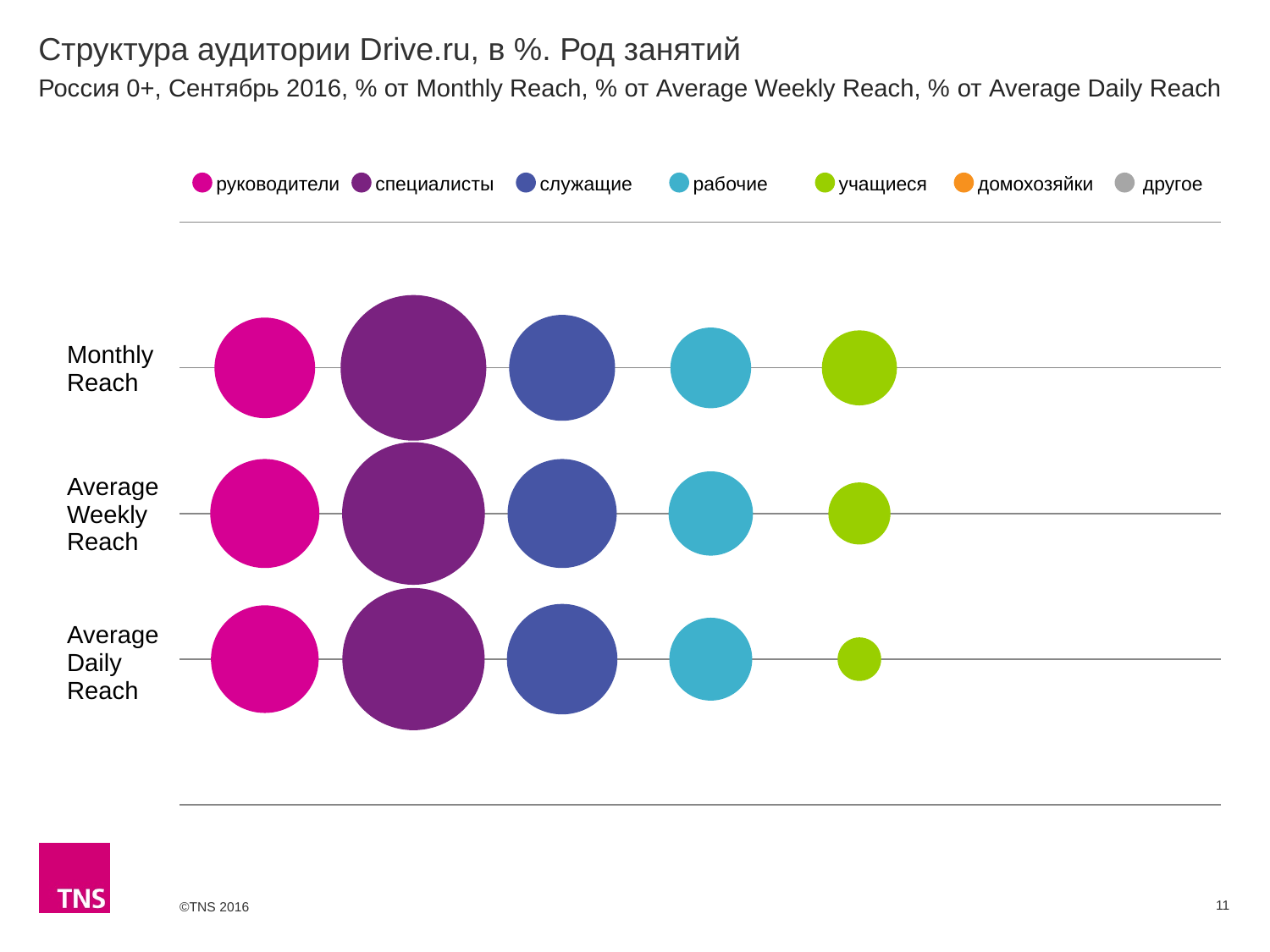
Which occupation group has the largest bubble in the Average Daily Reach row? специалисты In the Average Weekly Reach row, which bubble is larger: специалисты or руководители? специалисты Which occupation group has the largest bubble in the Monthly Reach row? специалисты How many reach categories (rows) are plotted on the chart? 3 How many series does the legend list? 7 Does the bubble for учащиеся get larger or smaller going from Monthly Reach to Average Daily Reach? smaller Among the visible bubbles in the Average Daily Reach row, which occupation group has the smallest bubble? учащиеся What kind of chart is shown on the slide? Bubble chart In the Monthly Reach row, which bubble is larger: служащие or учащиеся? служащие What is the title of the slide? Структура аудитории Drive.ru, в %. Род занятий Which two legend entries have no visible bubble in any row of the chart? домохозяйки and другое